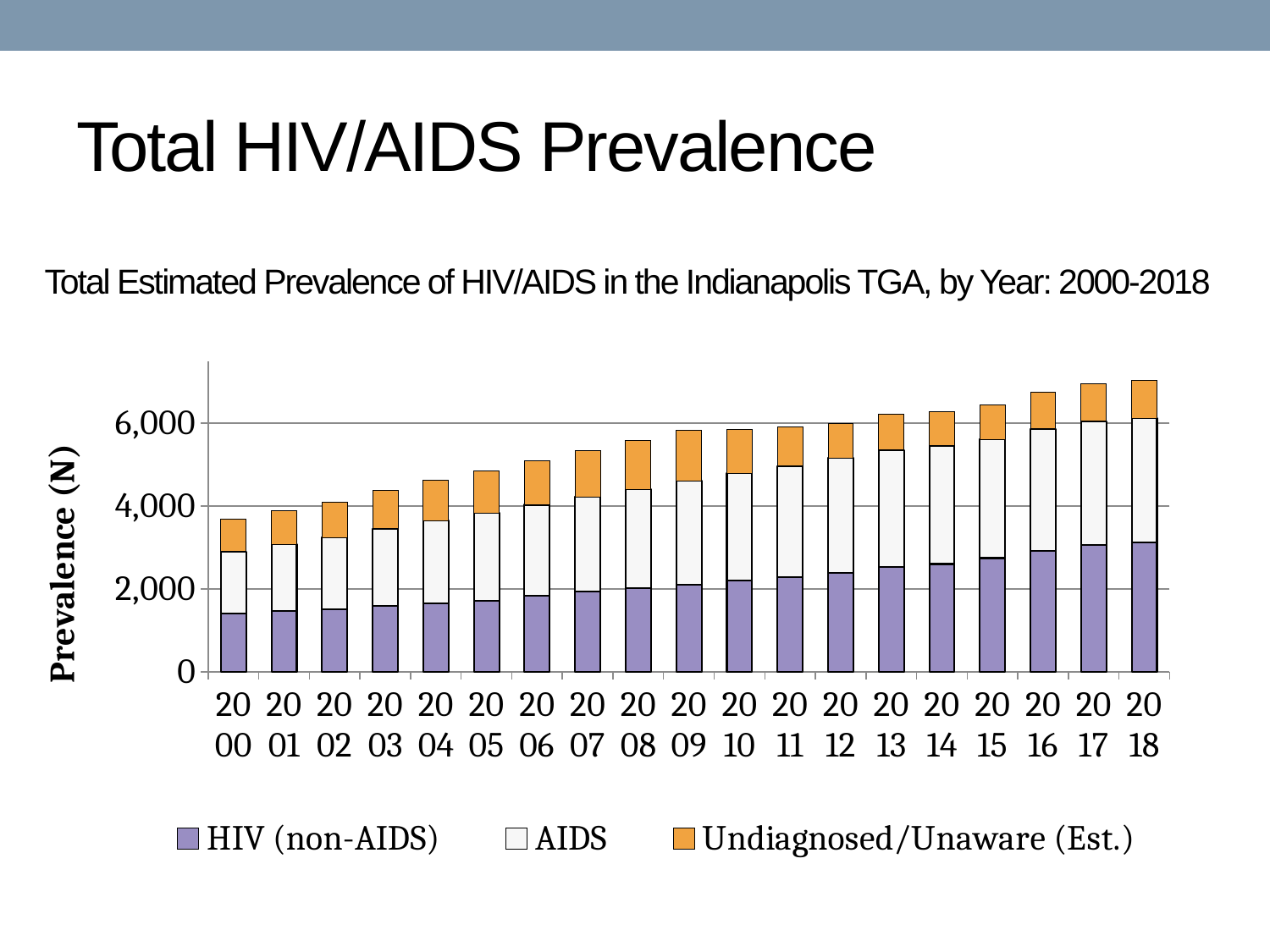
What kind of chart is shown on the slide? Stacked bar chart How many series does the legend list? 3 Is the HIV (non-AIDS) value for 2000 greater or less than 2,000? less Is the total prevalence for 2000 greater or less than 4,000? less Do the total prevalence values rise or fall from 2000 to 2018? Rise Which year has the lowest total estimated prevalence? 2000 What is the label on the vertical axis of the chart? Prevalence (N) Which year has the highest total estimated prevalence? 2018 Is the total prevalence for 2018 greater or less than 6,000? greater How many years (bars) are plotted on the chart? 19 Which year has the larger total prevalence, 2005 or 2016? 2016